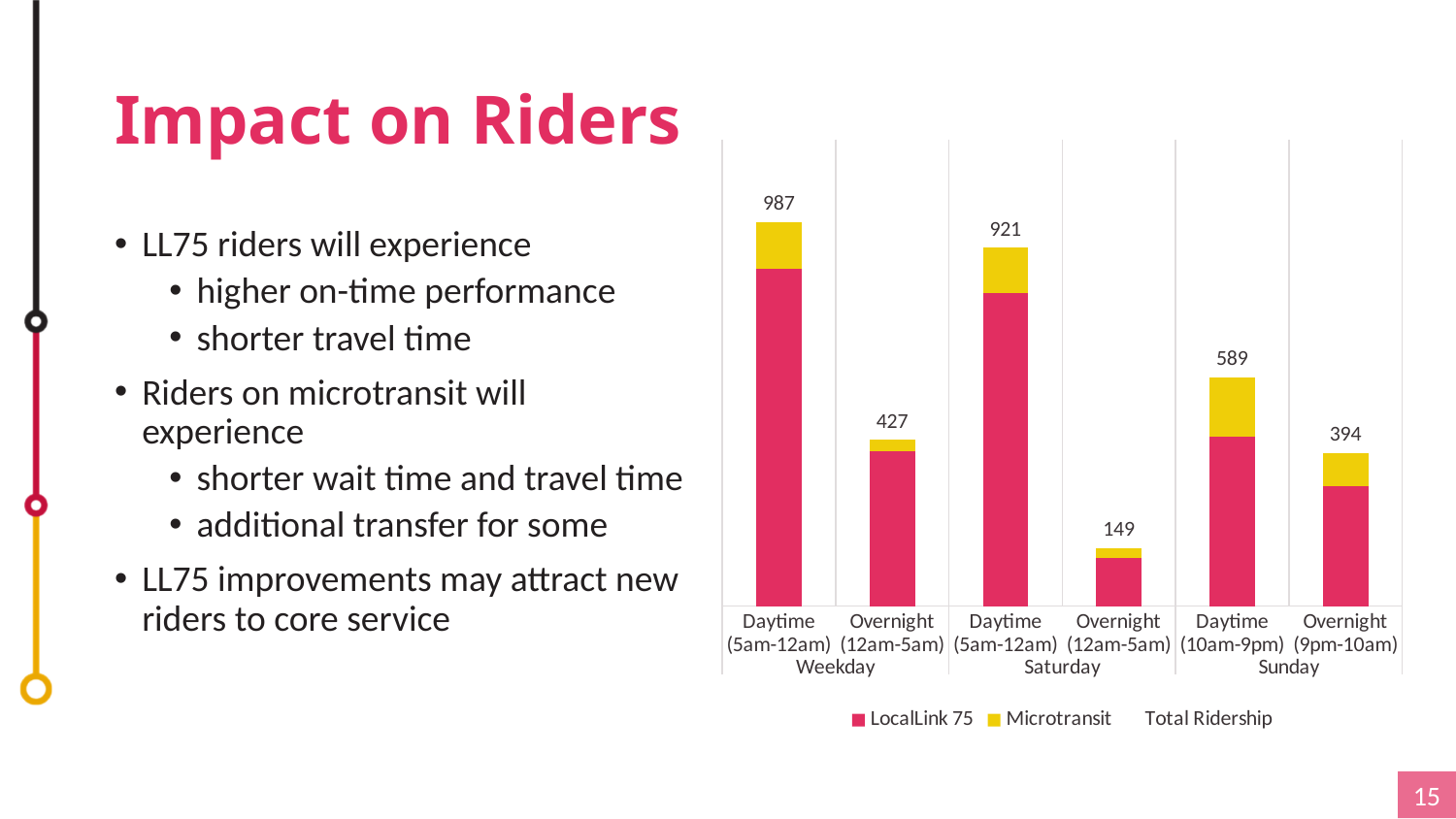
What is the total ridership shown for Saturday Overnight (12am-5am)? 149 Which has a larger total ridership, Weekday Overnight (12am-5am) or Sunday Overnight (9pm-10am)? Weekday Overnight (12am-5am) What kind of chart is shown on the slide? Stacked bar chart What is the total ridership shown for Weekday Daytime (5am-12am)? 987 What is the total ridership shown for Sunday Daytime (10am-9pm)? 589 Which time period has the highest total ridership? Weekday Daytime (5am-12am) Which time period has the lowest total ridership? Saturday Overnight (12am-5am) What is the difference in total ridership between Sunday Daytime (10am-9pm) and Sunday Overnight (9pm-10am)? 195 What is the total ridership shown for Weekday Overnight (12am-5am)? 427 What is the difference in total ridership between Weekday Daytime (5am-12am) and Saturday Daytime (5am-12am)? 66 How many entries does the chart legend list? 3 How many time-period categories are plotted in the chart? 6